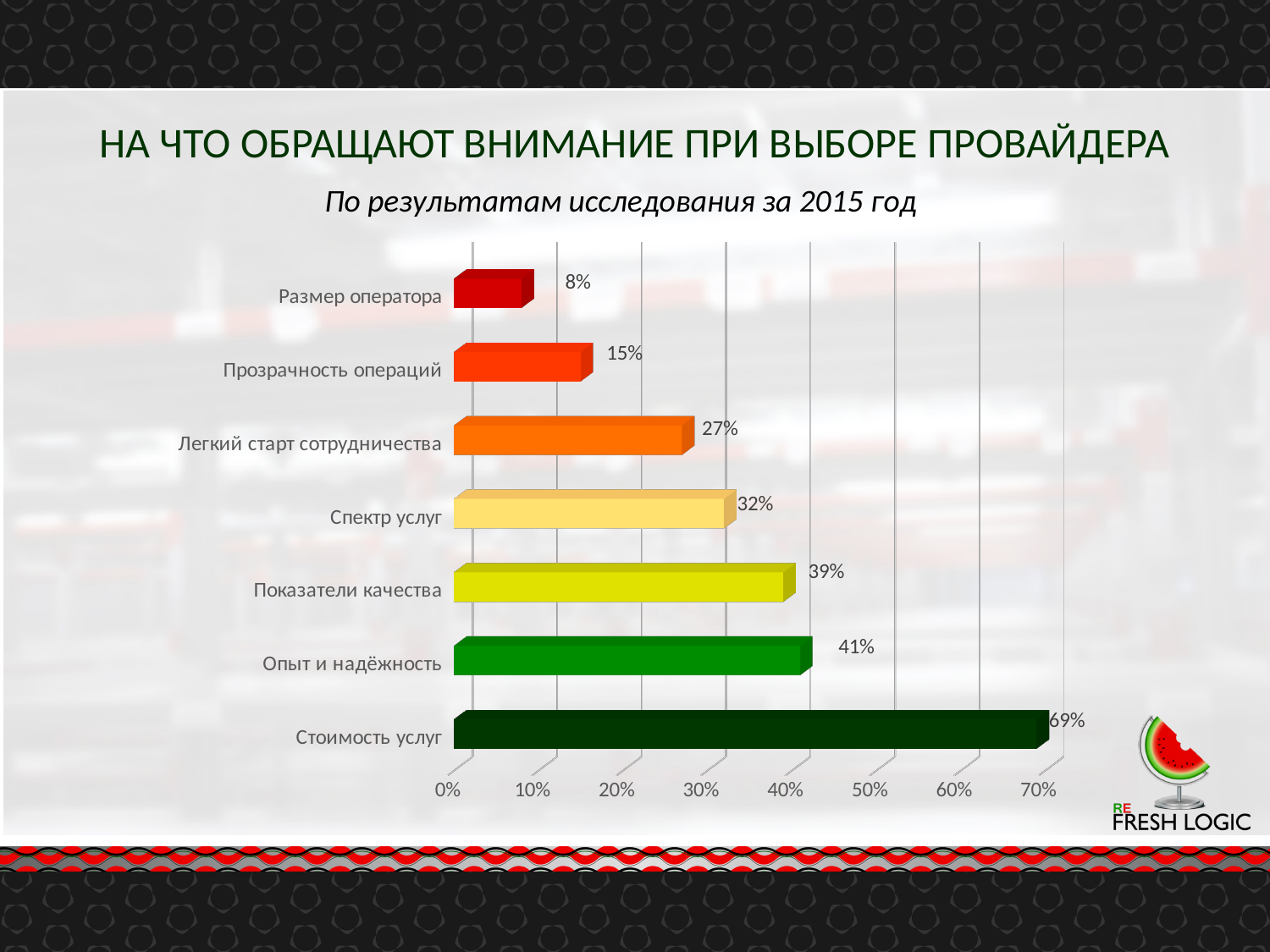
Which is larger, the value for Показатели качества or the value for Спектр услуг? Показатели качества What kind of chart is shown on the slide? Bar chart What is the subtitle shown below the chart title? По результатам исследования за 2015 год What is the value for Спектр услуг? 32% What is the difference between the values for Прозрачность операций and Размер оператора? 7% What is the value for Размер оператора? 8% What is the difference between the values for Стоимость услуг and Опыт и надёжность? 28% How many categories are shown in the chart? 7 What is the value for Легкий старт сотрудничества? 27% Which category has the lowest value? Размер оператора What is the value for Стоимость услуг? 69% Which category has the highest value? Стоимость услуг